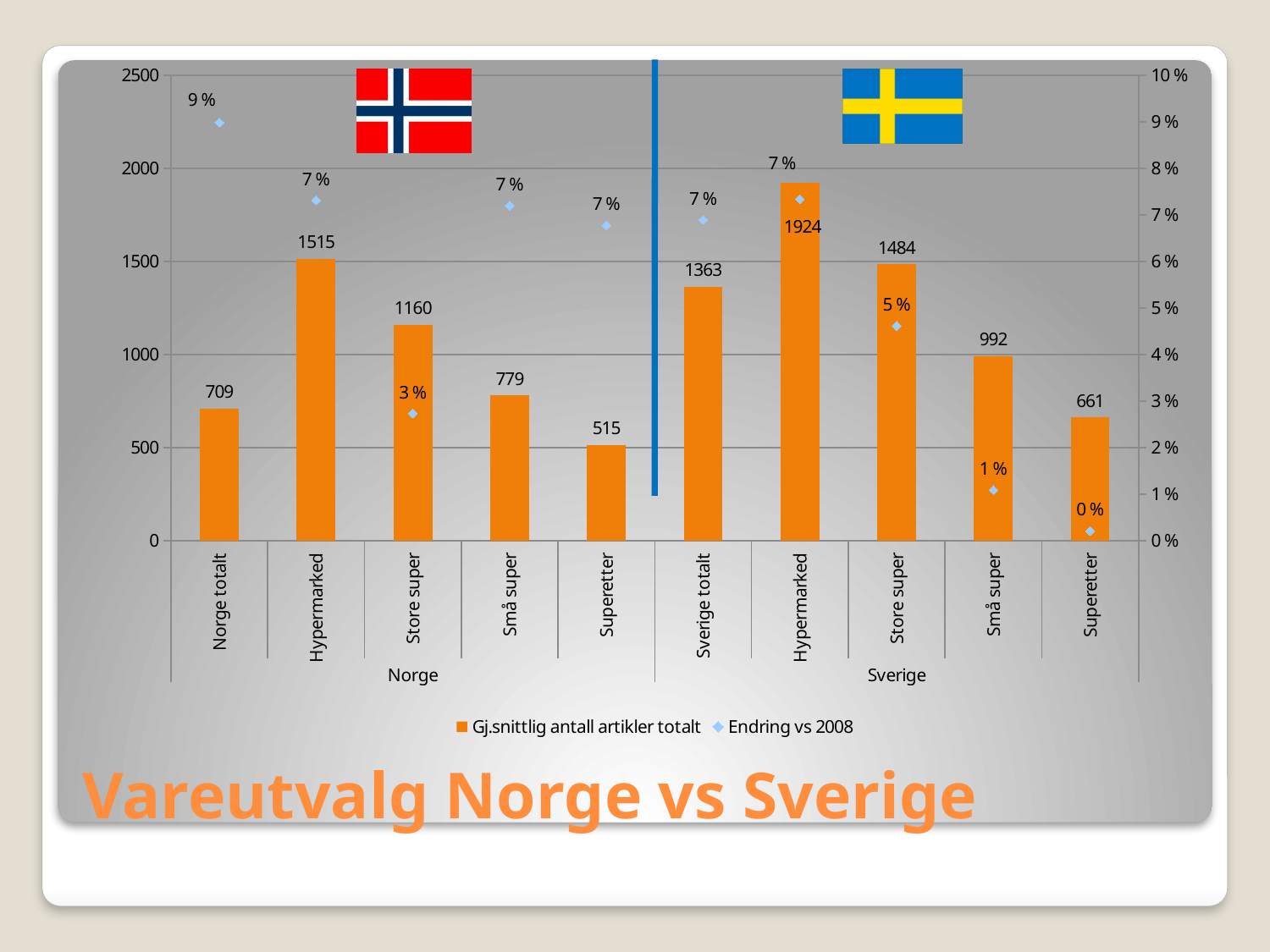
What is the Endring vs 2008 value for Norge totalt? 9 % What is the average number of articles (Gj.snittlig antall artikler totalt) for Norge totalt? 709 What is the Endring vs 2008 value for Små super in the Sverige group? 1 % How many series does the legend list? 2 Which has a larger average number of articles: Store super in Norge or Store super in Sverige? Store super in Sverige Which category has the highest average number of articles? Hypermarked (Sverige) How many categories are shown on the x axis? 10 Which category has the lowest average number of articles? Superetter (Norge) What is the difference in average number of articles between Hypermarked in Sverige and Hypermarked in Norge? 409 What kind of chart is used for the Gj.snittlig antall artikler totalt series? Bar chart What is the title of the slide? Vareutvalg Norge vs Sverige What is the average number of articles for Hypermarked in the Sverige group? 1924